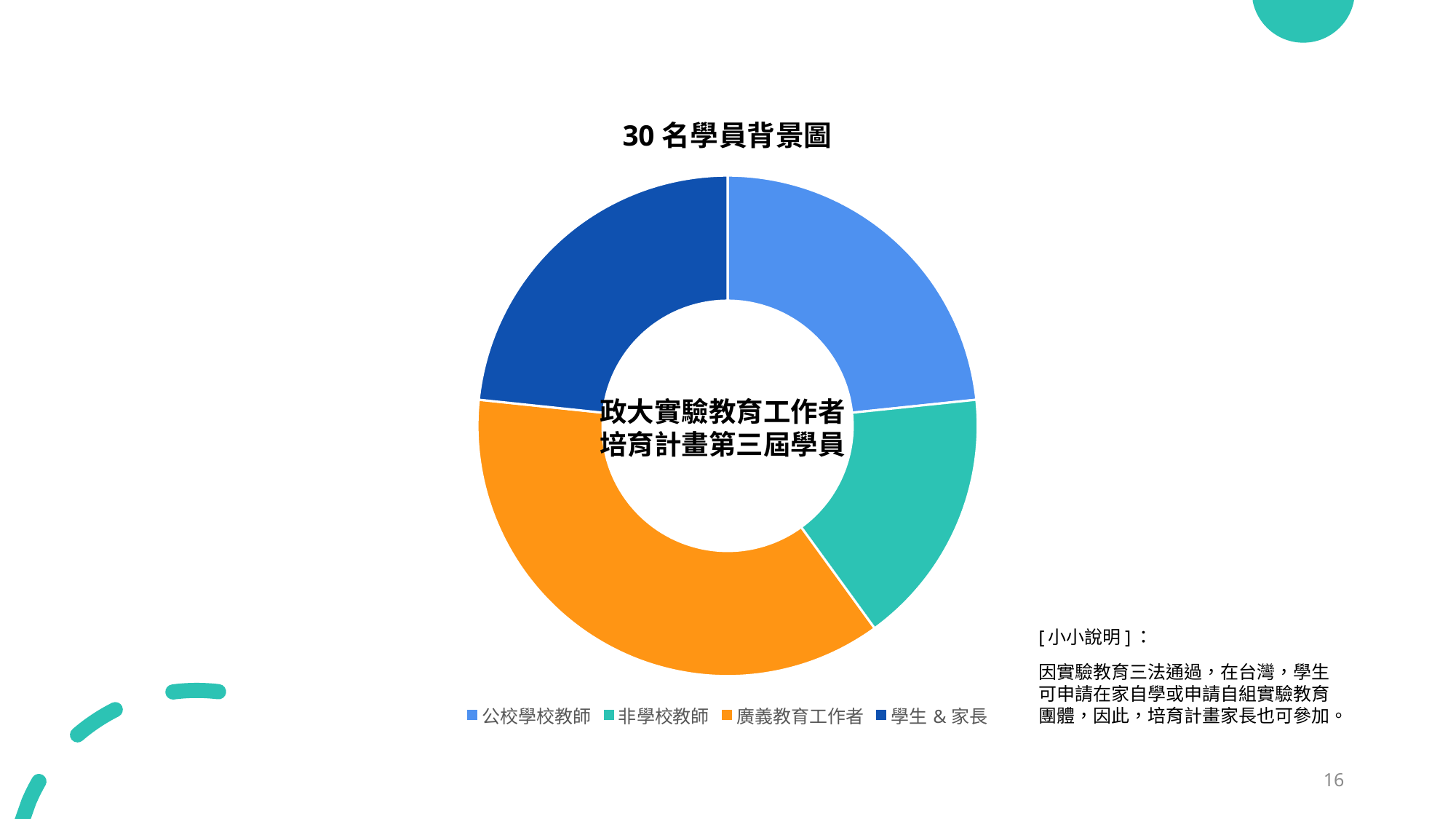
What kind of chart is shown on the slide? Doughnut (pie) chart What colour is the slice for 廣義教育工作者? Orange Which slice is larger, 廣義教育工作者 or 公校學校教師? 廣義教育工作者 How many categories does the chart's legend list? 4 Which category is shown in teal (green-blue)? 非學校教師 Which slice is larger, 廣義教育工作者 or 非學校教師? 廣義教育工作者 Which category has the smallest slice of the chart? 非學校教師 Which slice is larger, 非學校教師 or 學生 & 家長? 學生 & 家長 Which category has the largest slice of the chart? 廣義教育工作者 What is the title of the chart? 30 名學員背景圖